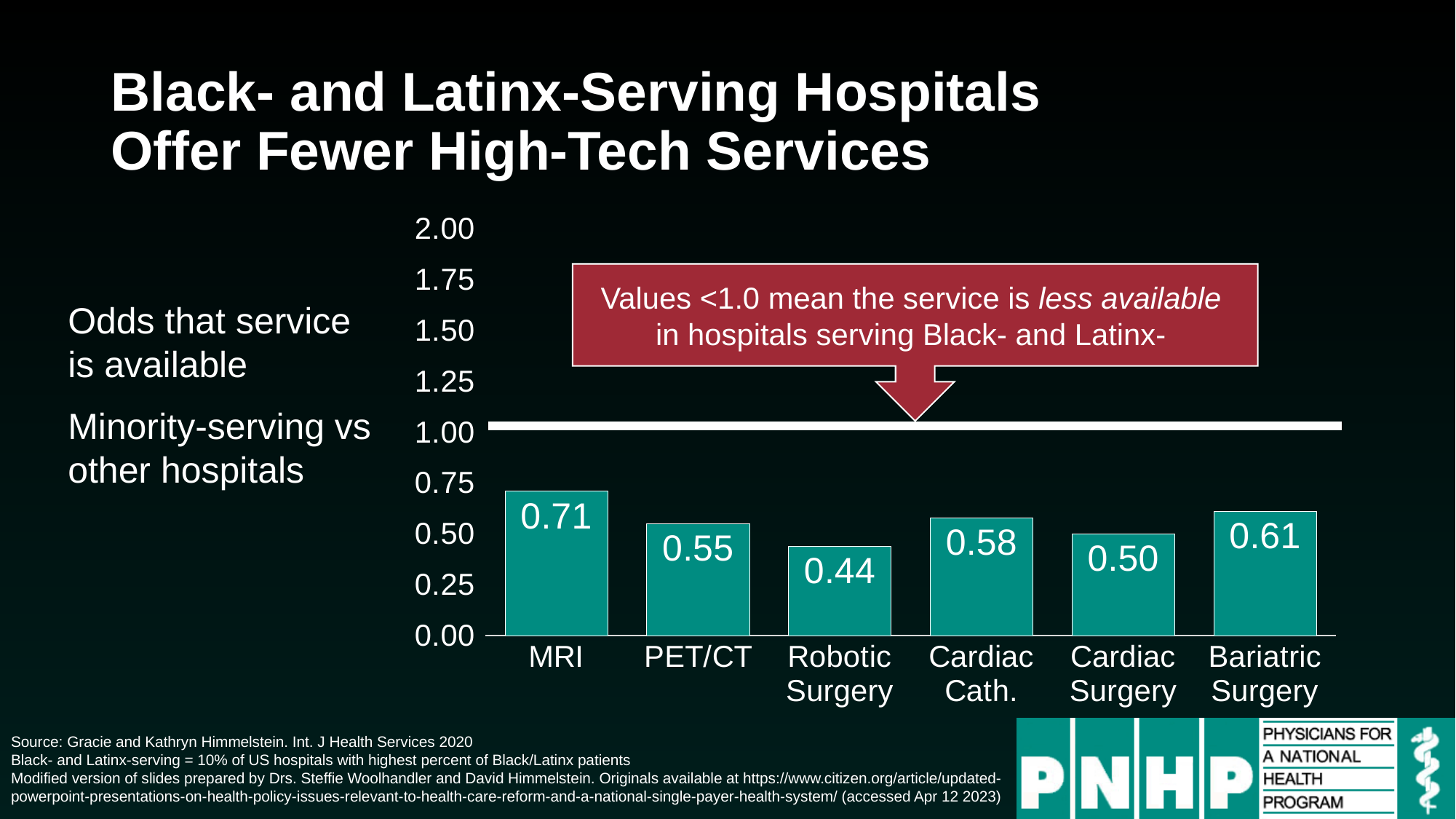
Which service has the lowest odds value? Robotic Surgery Which service has the highest odds value? MRI What is the difference between the odds values for Bariatric Surgery and PET/CT? 0.06 What kind of chart is shown on the slide? bar chart What is the difference between the odds values for MRI and Robotic Surgery? 0.27 Which has a larger odds value, Cardiac Cath. or Cardiac Surgery? Cardiac Cath. Is the value for PET/CT greater or less than 1.00? less What is the odds value for Robotic Surgery? 0.44 What is the odds value for Cardiac Surgery? 0.50 What is the odds value for MRI? 0.71 What is the maximum value shown on the vertical axis? 2.00 How many services are shown on the chart? 6